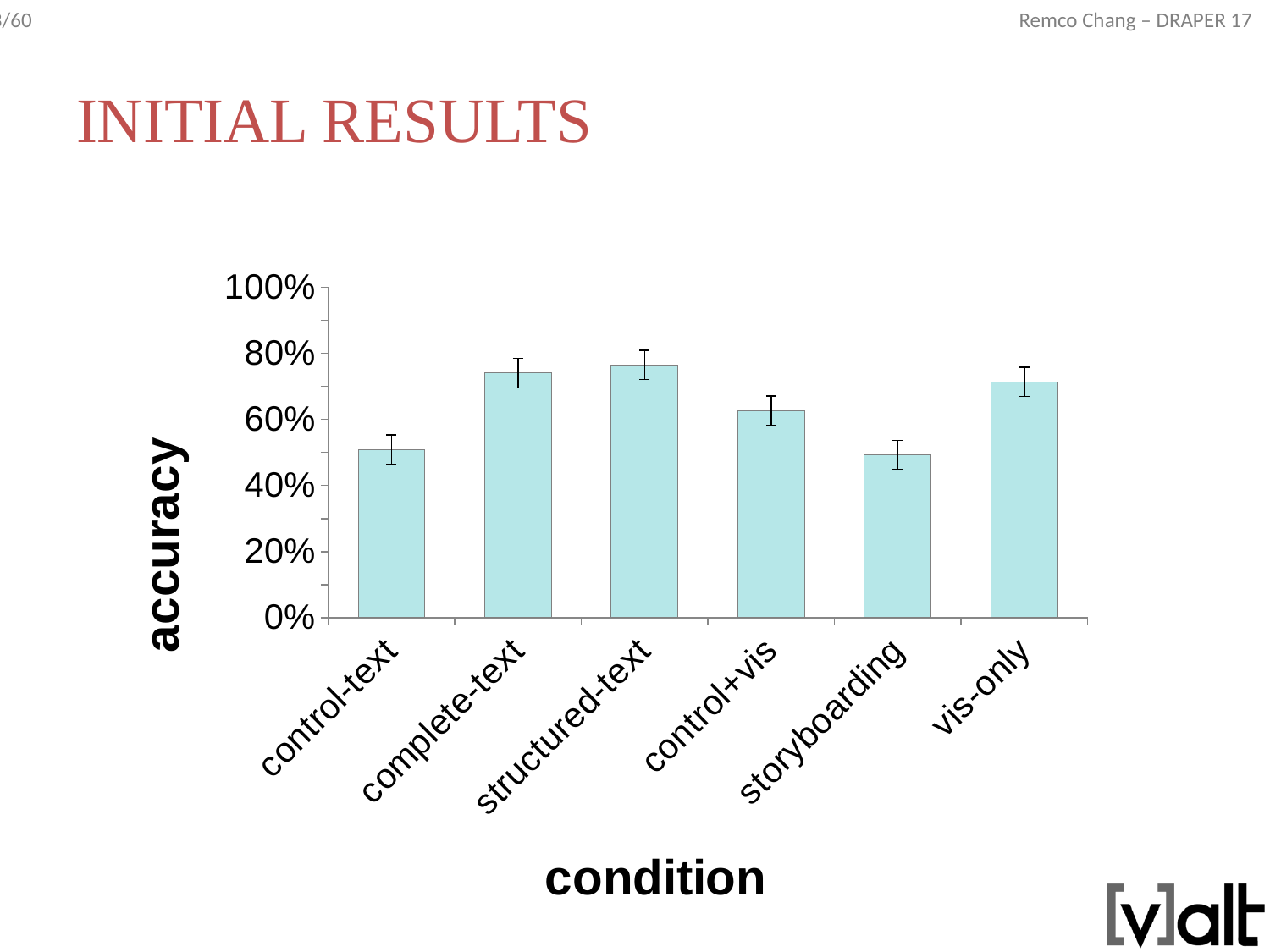
Which condition has higher accuracy, complete-text or control-text? complete-text Is the accuracy for storyboarding greater or less than 60%? less What is the label on the horizontal axis of the chart? condition Is the accuracy for structured-text greater or less than 80%? less Which condition has higher accuracy, vis-only or storyboarding? vis-only Is the accuracy for complete-text greater or less than 60%? greater What is the label on the vertical axis of the chart? accuracy How many conditions are plotted on the x axis of the chart? 6 What kind of chart is shown on the slide? bar chart